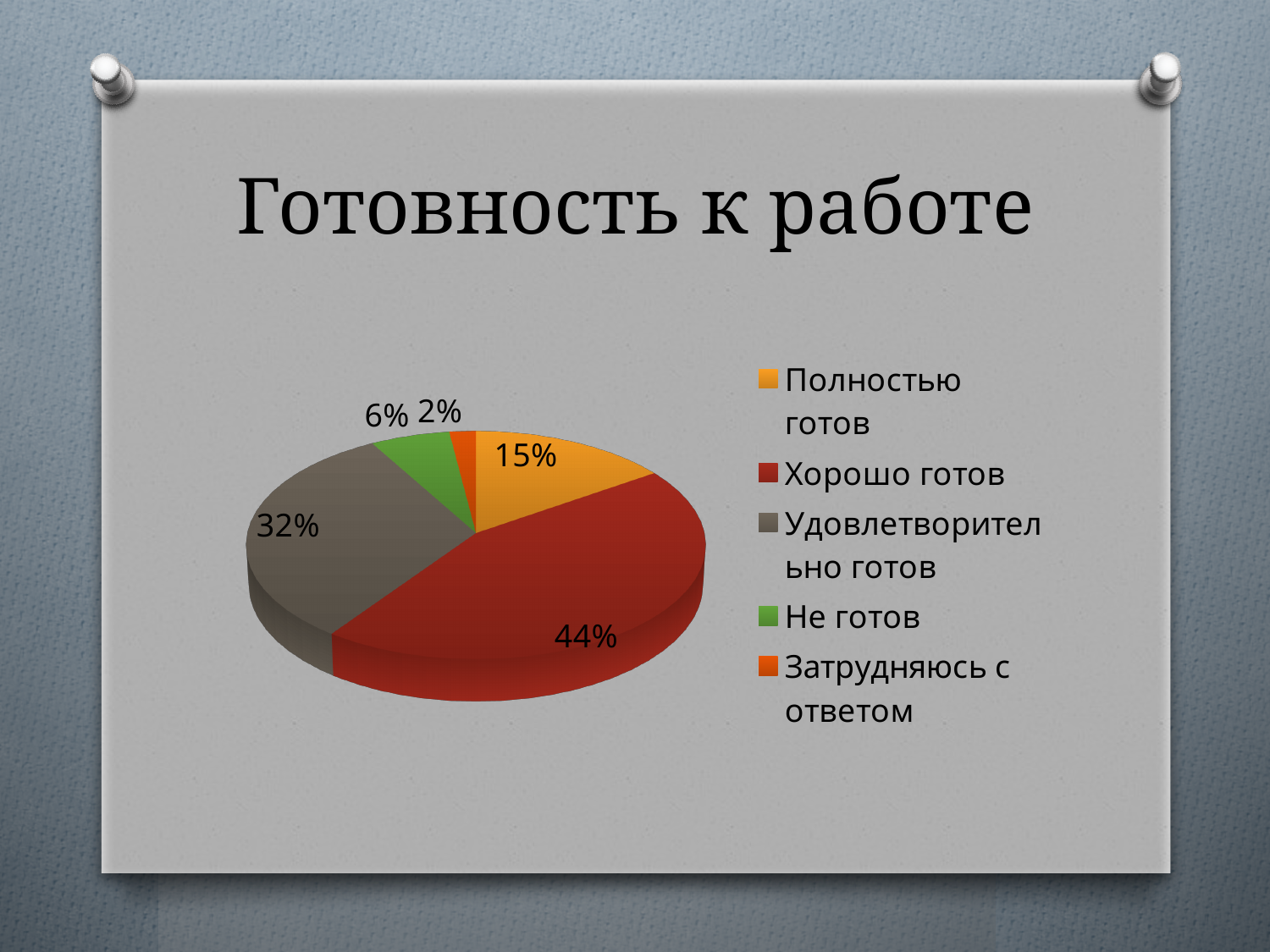
What share of the pie is labelled "Полностью готов"? 15% Which category has the largest slice of the pie? Хорошо готов What share of the pie is labelled "Хорошо готов"? 44% Which category has the smallest slice of the pie? Затрудняюсь с ответом What share of the pie is labelled "Не готов"? 6% Which is larger: the share for "Полностью готов" or the share for "Не готов"? Полностью готов What type of chart is shown on the slide? pie chart What is the difference between the shares for "Хорошо готов" and "Удовлетворительно готов"? 12% How many categories does the legend list? 5 What is the title of the chart on the slide? Готовность к работе